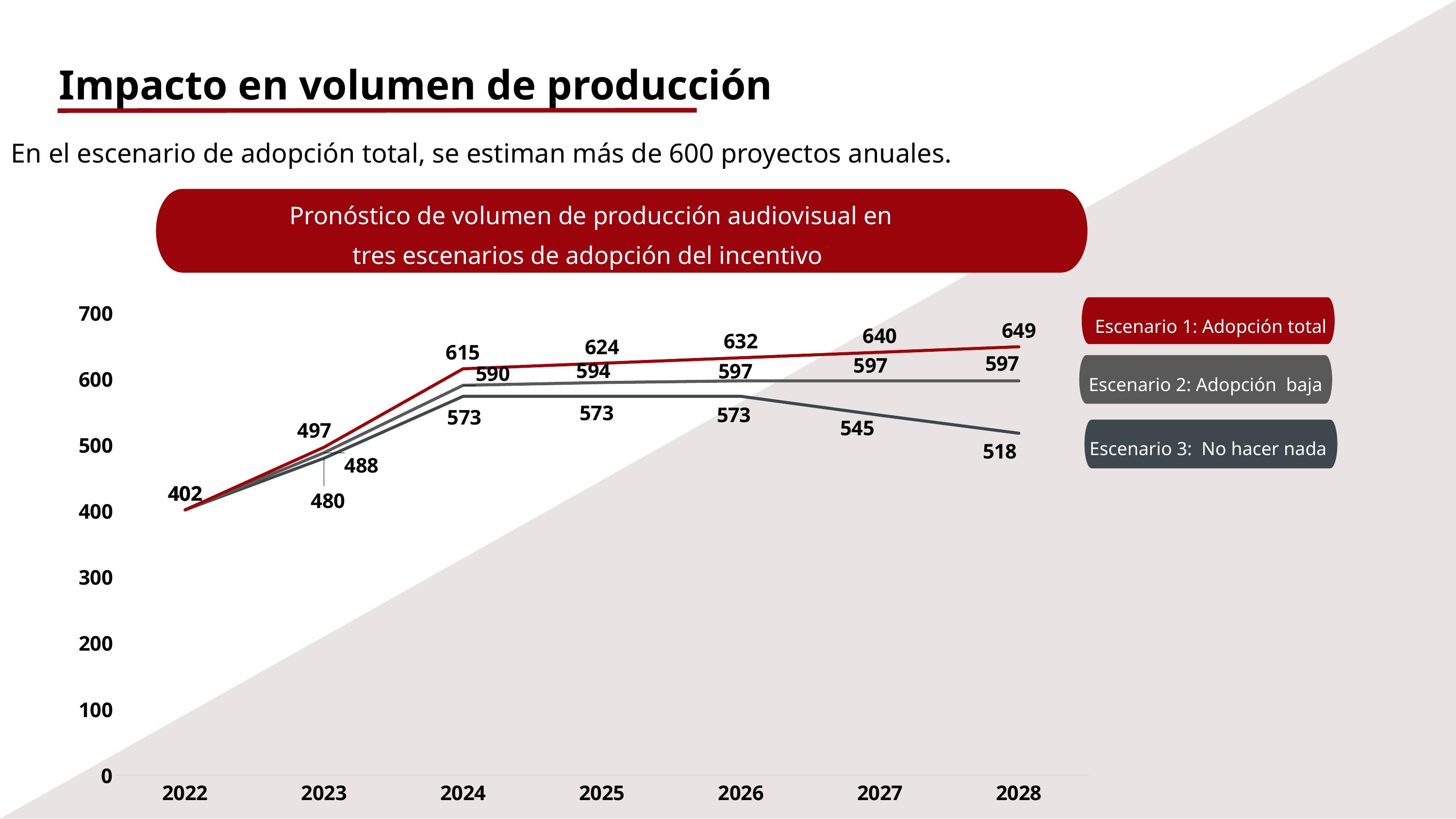
In which year does Escenario 1: Adopción total reach its highest value? 2028 Which is larger in 2026, Escenario 2: Adopción baja or Escenario 3: No hacer nada? Escenario 2: Adopción baja What is the value for Escenario 3: No hacer nada in 2027? 545 What is the difference between Escenario 1: Adopción total and Escenario 3: No hacer nada in 2028? 131 What is the value for Escenario 2: Adopción baja in 2024? 590 How many series does the legend list? 3 What is the value for Escenario 1: Adopción total in 2028? 649 What is the value for Escenario 1: Adopción total in 2023? 497 What is the title of the chart? Pronóstico de volumen de producción audiovisual en tres escenarios de adopción del incentivo Does Escenario 3: No hacer nada rise or fall between 2026 and 2028? fall How many years are shown on the x axis? 7 What type of chart is shown on the slide? line chart